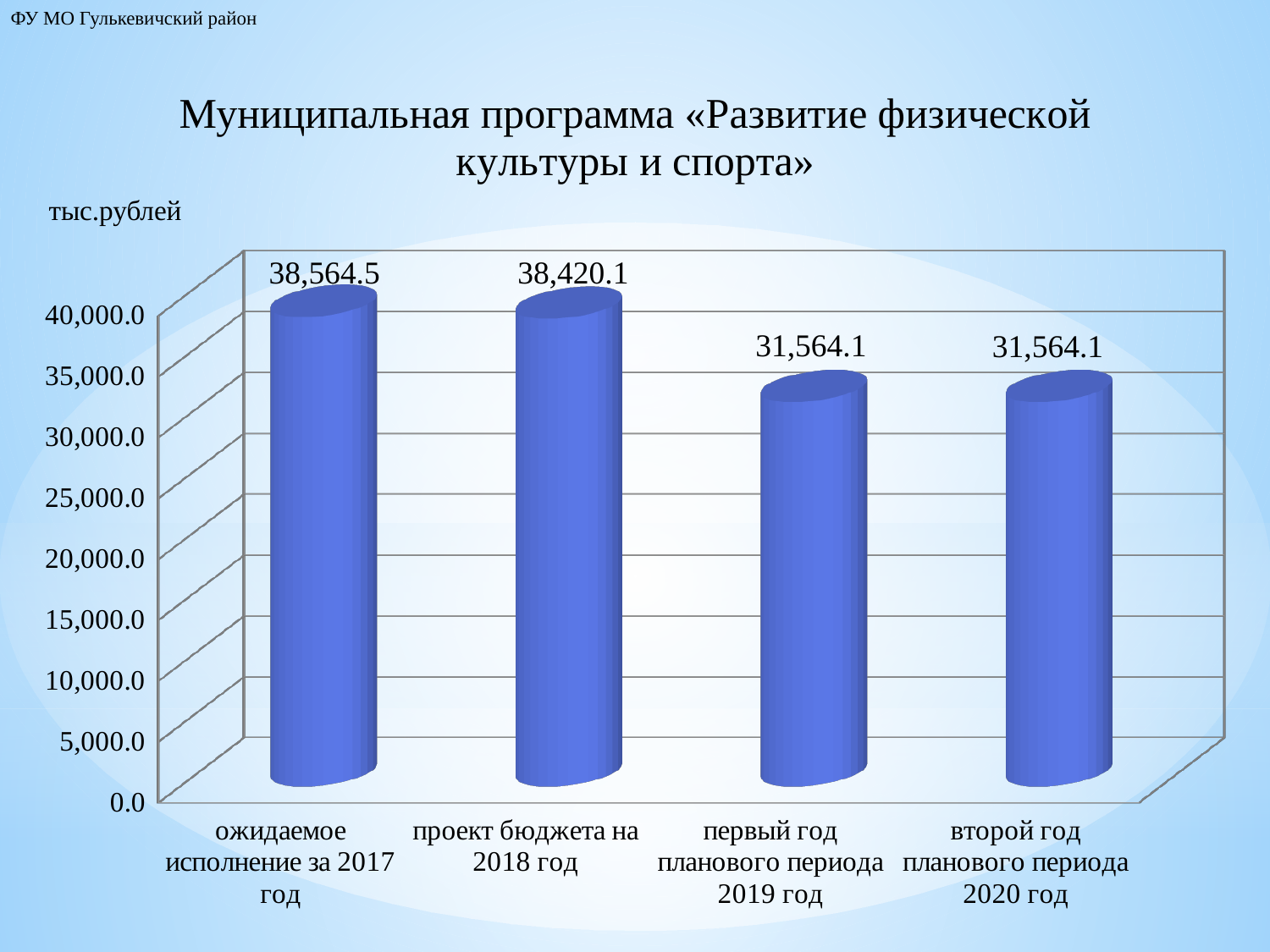
What is the difference between the values for 2017 (ожидаемое исполнение) and 2018 (проект бюджета)? 144.4 In what units are the values on the chart expressed, according to the label above the chart? тыс.рублей What is the value for «ожидаемое исполнение за 2017 год»? 38,564.5 Is the value for «ожидаемое исполнение за 2017 год» greater or less than 40,000.0? less Which is larger: the value for 2018 (проект бюджета) or for 2020 (второй год планового периода)? проект бюджета на 2018 год What is the value for «первый год планового периода 2019 год»? 31,564.1 Which category has the highest value? ожидаемое исполнение за 2017 год What is the value for «проект бюджета на 2018 год»? 38,420.1 What kind of chart is shown on the slide? bar chart What is the difference between the value for «проект бюджета на 2018 год» and «первый год планового периода 2019 год»? 6,856.0 How many categories are shown on the chart? 4 Is the value for «первый год планового периода 2019 год» greater or less than 30,000.0? greater